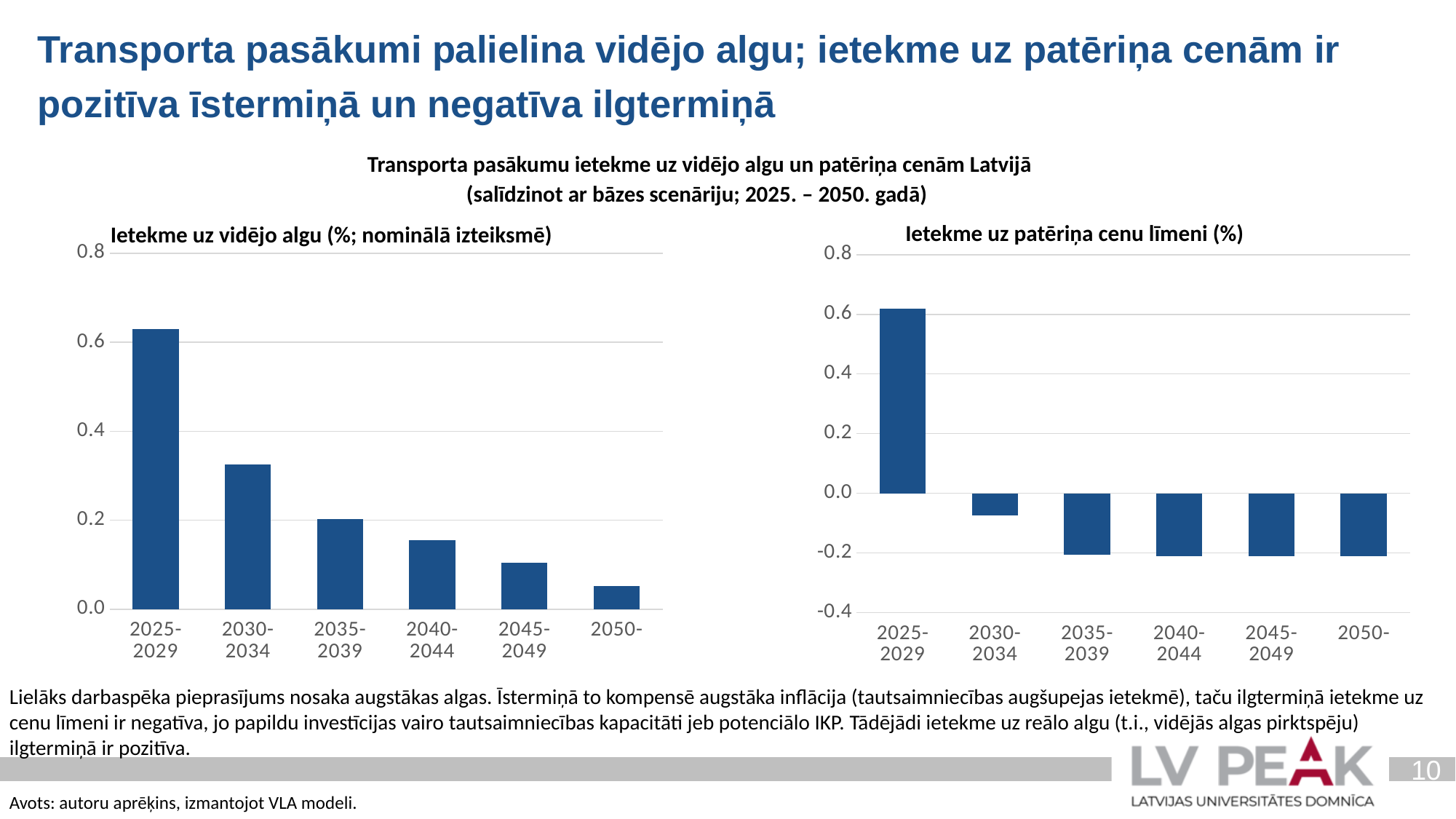
What kind of chart is the left chart, "Ietekme uz vidējo algu (%; nominālā izteiksmē)"? bar chart In the right chart, "Ietekme uz patēriņa cenu līmeni (%)", which period has the highest value? 2025-2029 How many periods are shown on the x axis of the left chart, "Ietekme uz vidējo algu"? 6 In the left chart, "Ietekme uz vidējo algu", which is larger: the value for 2035-2039 or the value for 2045-2049? 2035-2039 In the left chart, "Ietekme uz vidējo algu", do the values rise or fall from 2025-2029 to 2050-? fall What is the title of the right chart? Ietekme uz patēriņa cenu līmeni (%) In the left chart, "Ietekme uz vidējo algu", which period has the highest value? 2025-2029 In the left chart, "Ietekme uz vidējo algu", is the value for 2030-2034 greater or less than 0.4? less In the left chart, "Ietekme uz vidējo algu", is the value for 2025-2029 greater or less than 0.6? greater In the right chart, "Ietekme uz patēriņa cenu līmeni (%)", is the value for 2025-2029 greater or less than 0.4? greater In the left chart, "Ietekme uz vidējo algu", which period has the lowest value? 2050-